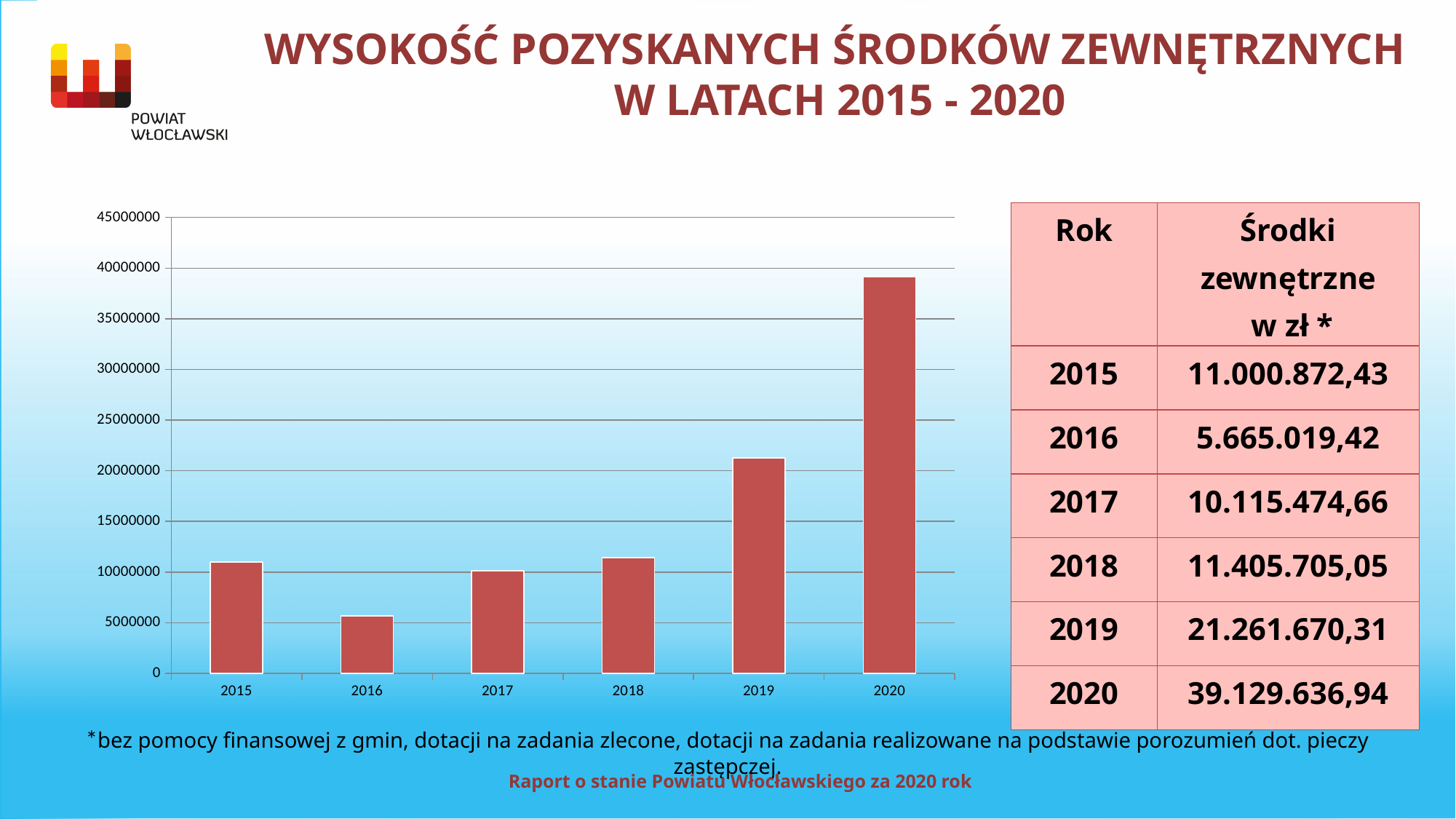
What is the difference between the external funds for 2020 and 2019? 17.867.966,63 What is the value of external funds (Środki zewnętrzne w zł) for 2019? 21.261.670,31 Do the values rise or fall from 2016 to 2020? rise What is the value of external funds (Środki zewnętrzne w zł) for 2016? 5.665.019,42 Is the value for 2019 greater or less than 20000000? greater How many years are shown on the x axis of the chart? 6 Which year has the lowest value of external funds obtained? 2016 What is the value of external funds (Środki zewnętrzne w zł) for 2020? 39.129.636,94 Which year has the larger value, 2015 or 2017? 2015 What type of chart is shown on the slide? bar chart Is the value for 2016 greater or less than 10000000? less Which year has the highest value of external funds obtained? 2020